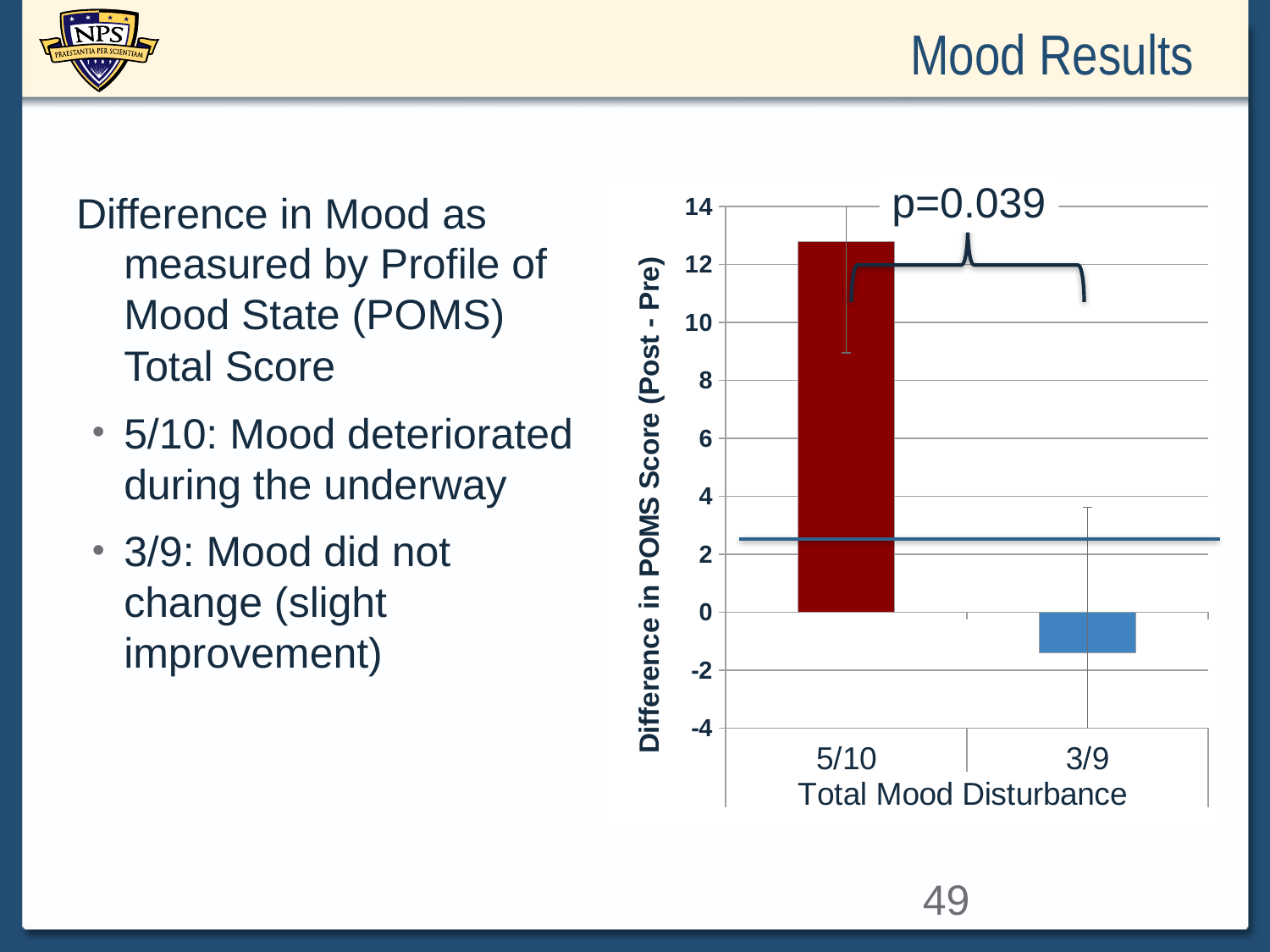
Is the value for 3/9 greater or less than -2? greater Is the value for 5/10 greater or less than 10? greater Which category has the highest value in the chart? 5/10 How many categories are plotted on the x axis of the chart? 2 What kind of chart is shown on the slide? bar chart What p-value is annotated on the chart? p=0.039 Which category has the lowest value in the chart? 3/9 Is the value for 3/9 greater or less than 0? less What is the label of the y axis of the chart? Difference in POMS Score (Post - Pre) Which has the larger value, 5/10 or 3/9? 5/10